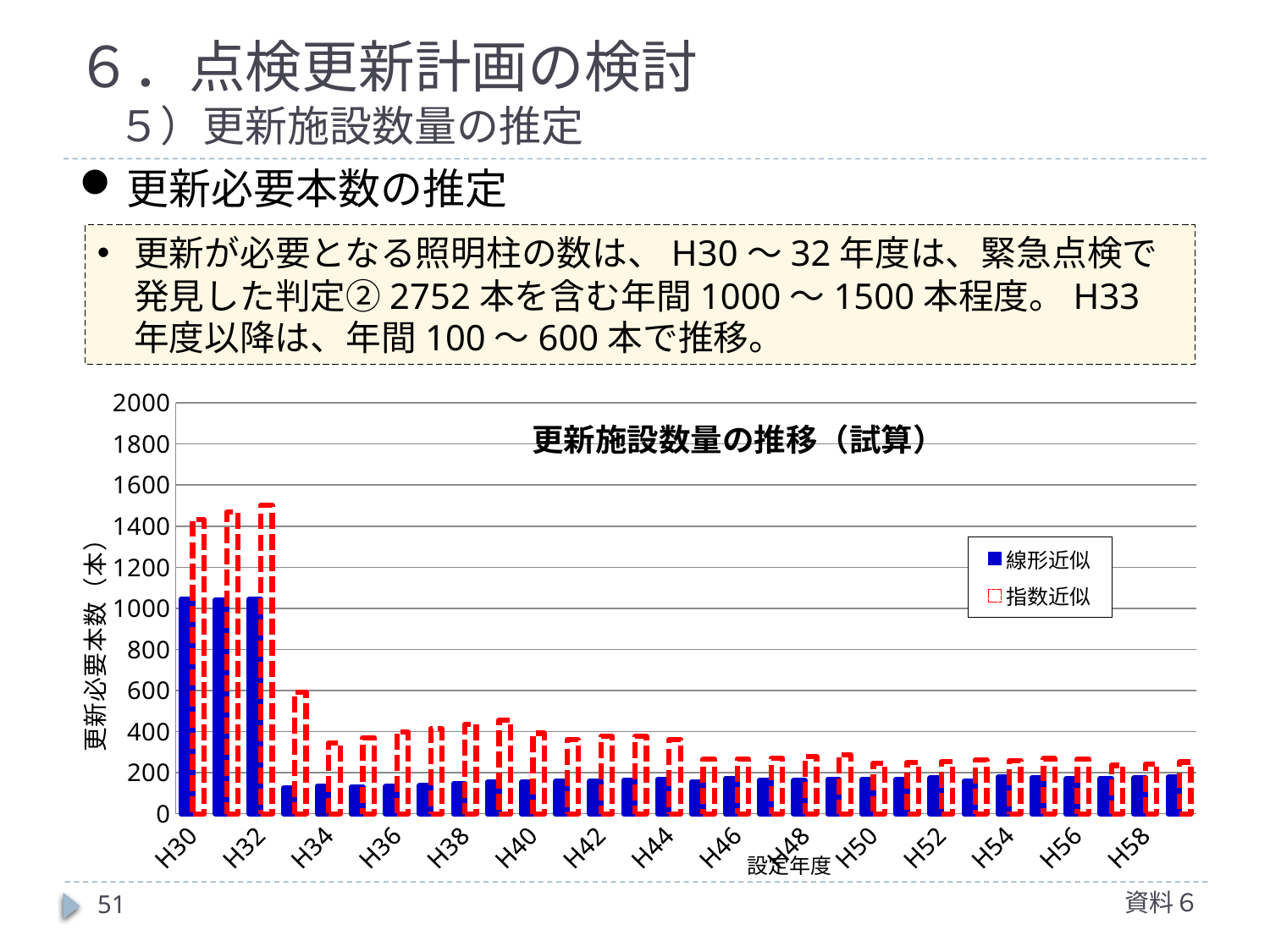
Is the 線形近似 value for H34 greater or less than 200? less For H30, which series has the larger value, 線形近似 or 指数近似? 指数近似 From H33 onward, do the 指数近似 values generally rise or fall along the x axis? fall For H33, which series has the larger value, 線形近似 or 指数近似? 指数近似 Is the 指数近似 value for H32 greater or less than 1200? greater Is the 線形近似 value for H30 greater or less than 1000? greater How many series does the chart legend list? 2 What is the title of the chart? 更新施設数量の推移（試算） What are the two series named in the legend? 線形近似 and 指数近似 What kind of chart is shown on the slide? bar chart